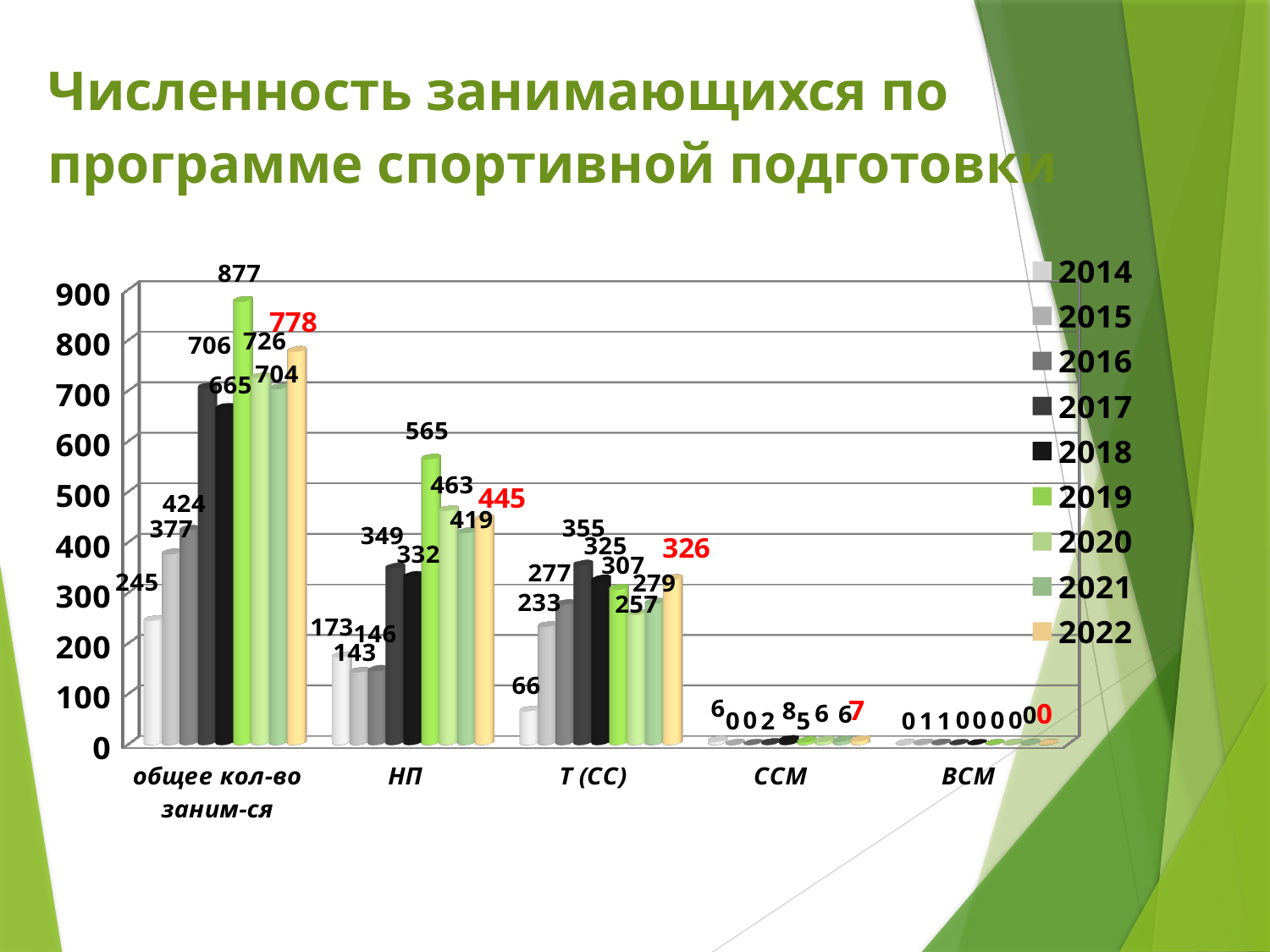
What is the difference between the 2019 and 2022 values in the общее кол-во заним-ся category? 99 Which is larger in the Т (СС) category: the value for 2017 or the value for 2022? 2017 What is the value for 2014 in the Т (СС) category? 66 What is the value for 2018 in the ССМ category? 8 What is the value for 2022 in the НП category? 445 What kind of chart is shown on the slide? bar chart How many series does the legend list? 9 What is the value for 2019 in the общее кол-во заним-ся category? 877 Which year has the highest value in the общее кол-во заним-ся category? 2019 How many categories are shown on the x axis? 5 Which year has the lowest value in the НП category? 2015 What is the title of the slide? Численность занимающихся по программе спортивной подготовки